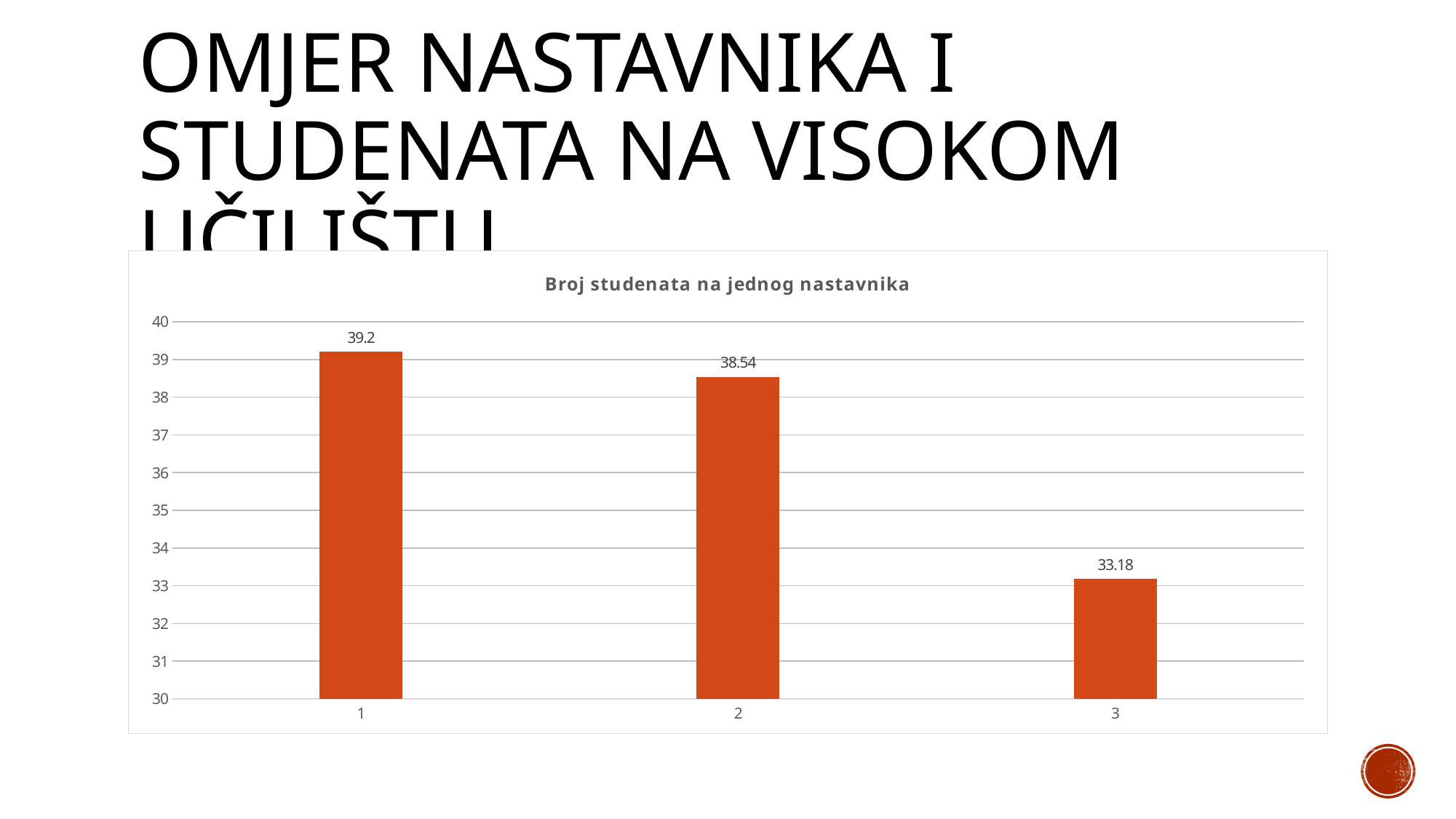
What is the value for category 1? 39.2 Which category has the highest value? 1 What is the title of the chart? Broj studenata na jednog nastavnika Which is larger, the value for category 2 or the value for category 3? category 2 Which category has the lowest value? 3 What is the difference between the values for category 2 and category 3? 5.36 What is the value for category 3? 33.18 What is the difference between the values for category 1 and category 3? 6.02 What kind of chart is shown on the slide? bar chart How many bars are shown in the chart? 3 What is the value for category 2? 38.54 Is the value for category 3 greater or less than 35? less